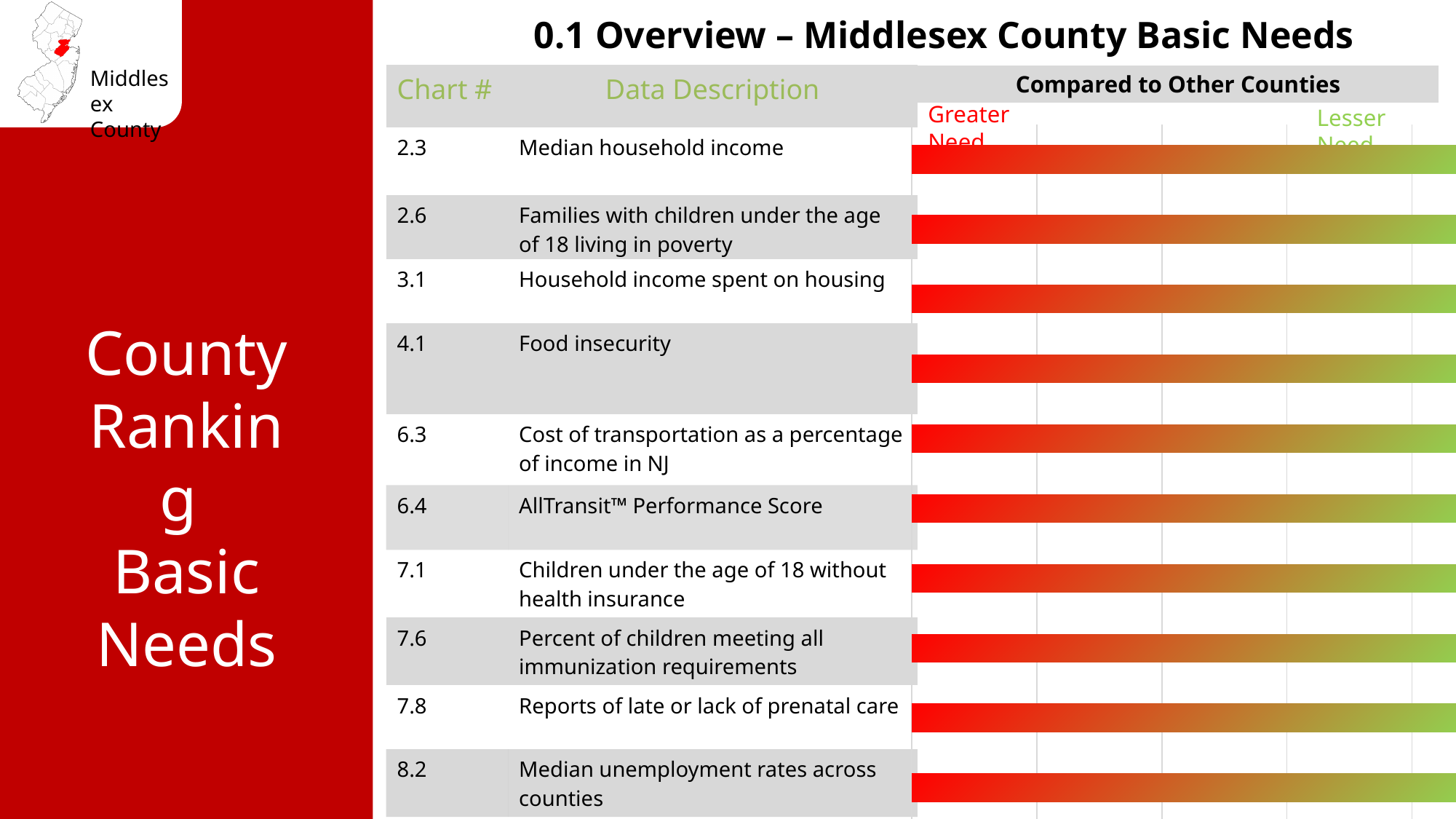
What kind of chart is used in the 'Compared to Other Counties' section? Bar chart What data description is listed for chart number 8.2 in the 'Compared to Other Counties' chart? Median unemployment rates across counties What data description is listed for chart number 7.8 in the 'Compared to Other Counties' chart? Reports of late or lack of prenatal care In the 'Compared to Other Counties' chart, which end of the bars is labelled 'Greater Need', the left or the right? Left What chart number is listed for 'Food insecurity' in the 'Compared to Other Counties' chart? 4.1 What is the title of the slide containing the 'Compared to Other Counties' chart? 0.1 Overview – Middlesex County Basic Needs What chart number is listed for 'Median household income' in the 'Compared to Other Counties' chart? 2.3 How many data description rows have a bar plotted in the 'Compared to Other Counties' chart? 10